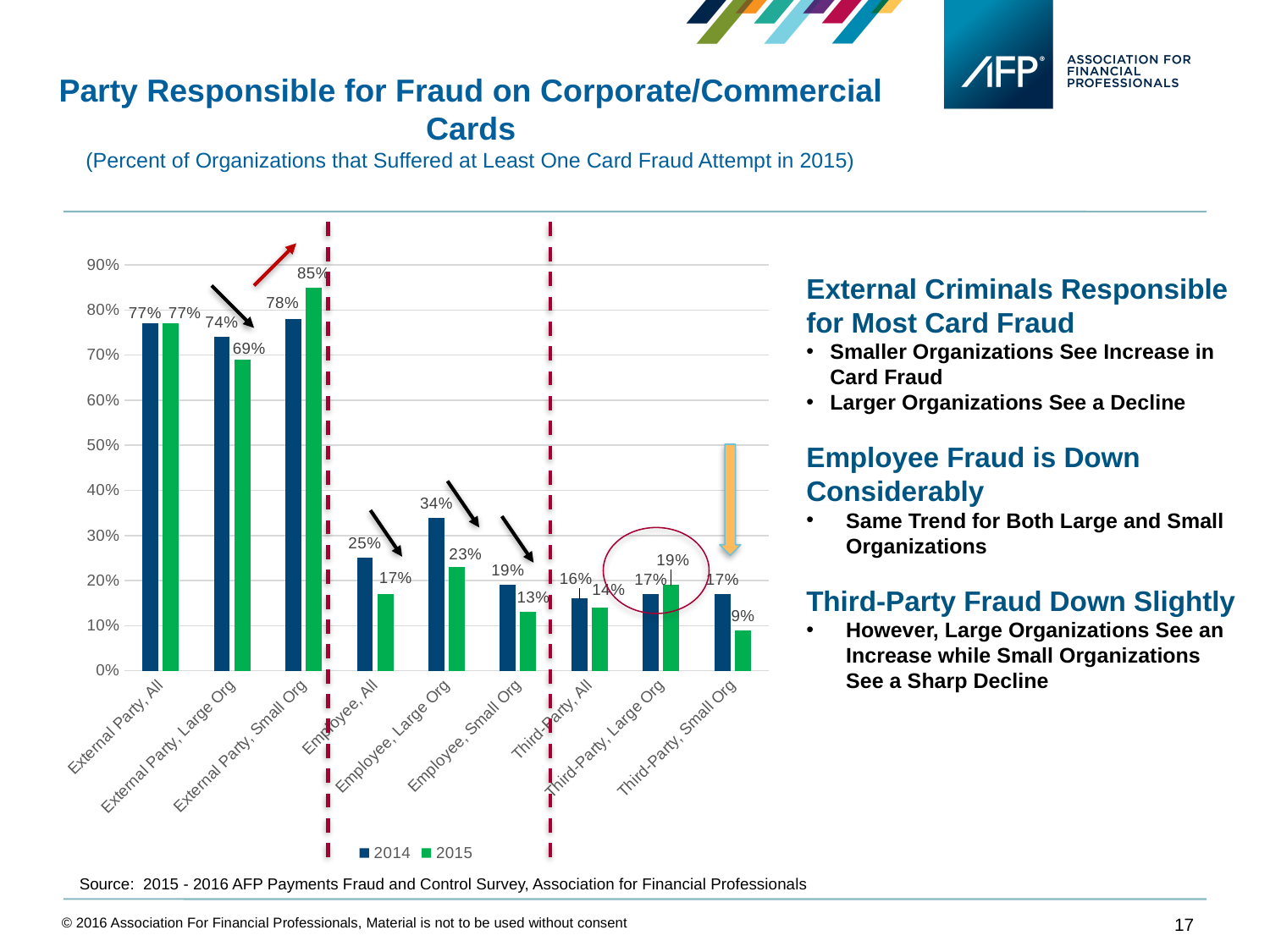
Which category has the highest 2015 value? External Party, Small Org How many categories are shown on the x axis? 9 Which is larger for Third-Party, Large Org: the 2014 value or the 2015 value? 2015 Is the 2014 value for External Party, Large Org greater or less than 70%? greater What is the 2015 value for Third-Party, Small Org? 9% Which series is shown in green in the legend? 2015 What is the 2014 value for Employee, Large Org? 34% Which category has the lowest 2015 value? Third-Party, Small Org How many series does the legend list? 2 What kind of chart is shown on the slide? Bar chart What is the 2015 value for External Party, Small Org? 85% What is the difference between the 2014 and 2015 values for Employee, Large Org? 11%